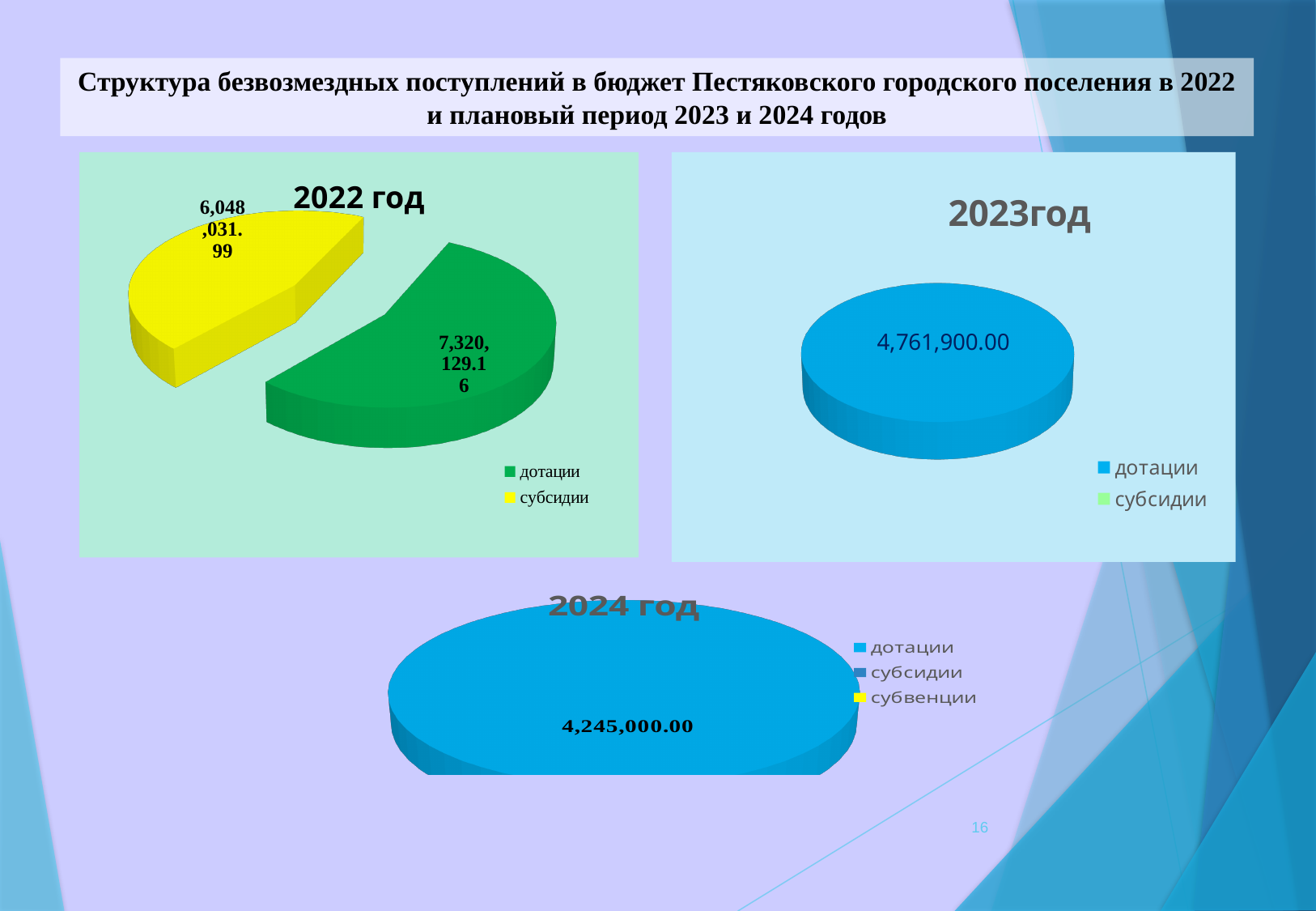
In the 2022 год chart, what is the difference between дотации and субсидии? 1,272,097.17 Which is larger: the дотации value in the 2023год chart or in the 2024 год chart? 2023год In the 2022 год chart, what is the value for дотации? 7,320,129.16 In the 2022 год chart, what is the value for субсидии? 6,048,031.99 In the 2022 год chart, which category has the larger value? дотации In the 2023год chart, what value is printed on the pie? 4,761,900.00 In the 2022 год chart, which category has the smaller value? субсидии In the 2022 год chart, what is the total of the two slices? 13,368,161.15 In the 2024 год chart, what value is printed on the pie? 4,245,000.00 What kind of chart is the 2022 год chart? pie chart In the 2022 год chart, what colour is the субсидии slice? yellow How many entries does the legend of the 2024 год chart list? 3